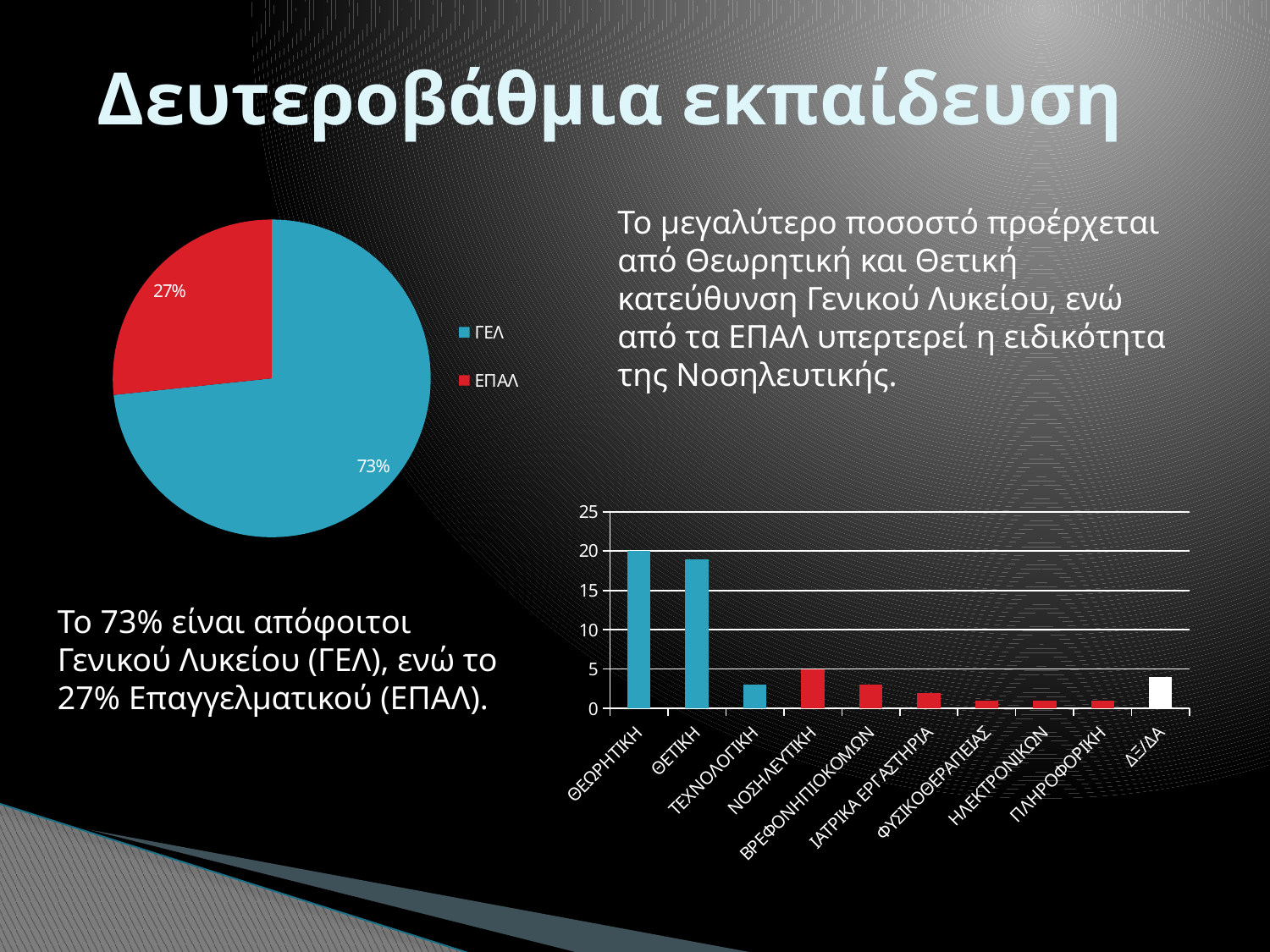
In the bar chart, is the value for ΘΕΤΙΚΗ greater or less than 15? greater In the bar chart, is the value for ΔΞ/ΔΑ greater or less than 5? less In the pie chart, what percentage is shown for ΓΕΛ? 73% In the bar chart, is the value for ΤΕΧΝΟΛΟΓΙΚΗ greater or less than 5? less In the bar chart, how many categories are shown on the x axis? 10 What kind of chart is the chart at the bottom right of the slide? bar chart How many entries does the legend of the pie chart list? 2 In the bar chart, which is larger, the value for ΝΟΣΗΛΕΥΤΙΚΗ or the value for ΙΑΤΡΙΚΑ ΕΡΓΑΣΤΗΡΙΑ? ΝΟΣΗΛΕΥΤΙΚΗ In the pie chart, what is the difference in percentage points between ΓΕΛ and ΕΠΑΛ? 46 In the bar chart, what colour is the bar for ΔΞ/ΔΑ? white In the pie chart, which category has the larger slice? ΓΕΛ In the pie chart, what percentage is shown for ΕΠΑΛ? 27%